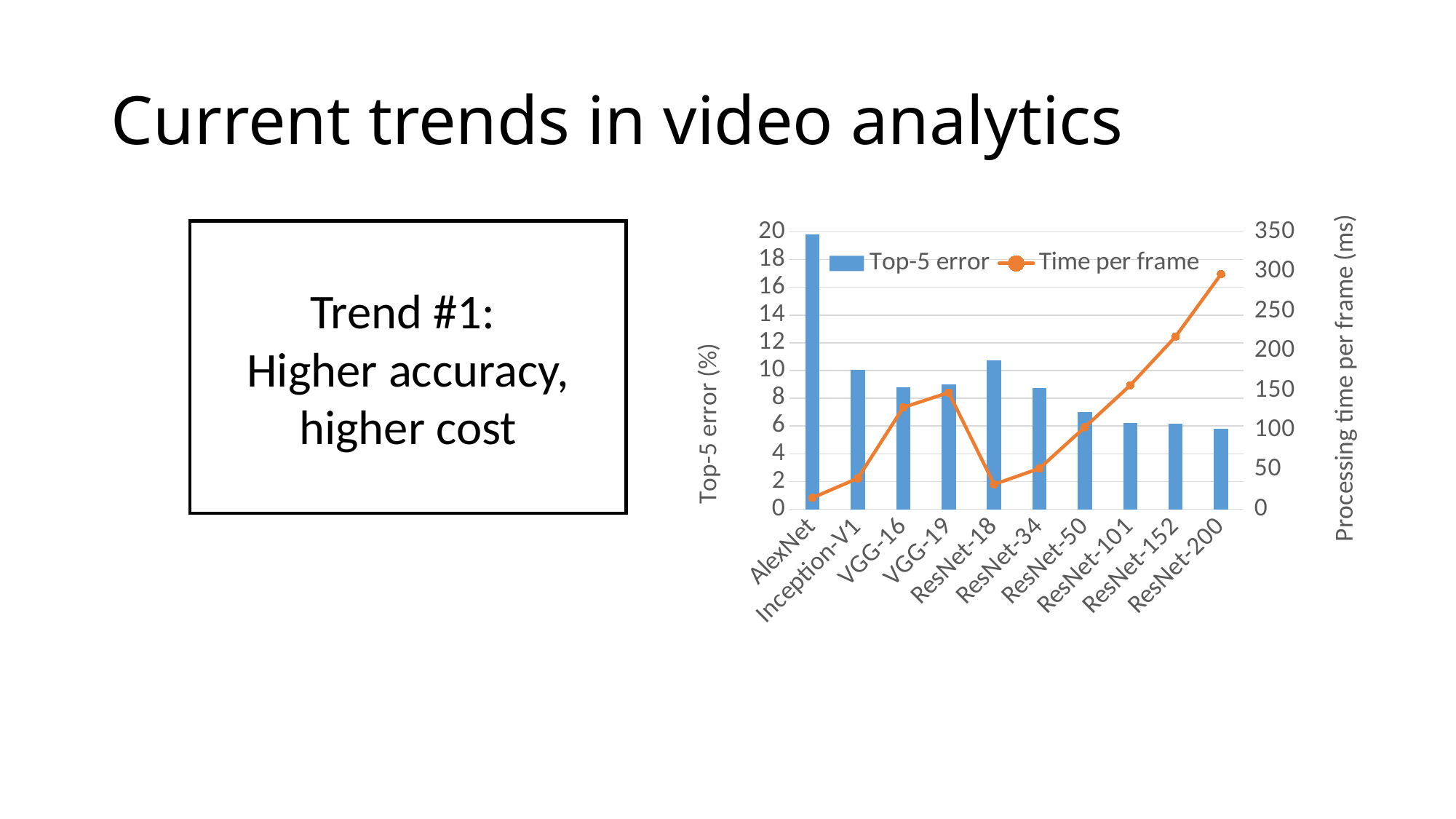
What kind of chart is shown on the slide? A combined bar and line chart Which has the larger time per frame, VGG-19 or ResNet-18? VGG-19 Is the time per frame for ResNet-18 greater or less than 50? less Which model has the lowest time per frame? AlexNet What is the label of the right-hand vertical axis? Processing time per frame (ms) Is the time per frame for ResNet-200 greater or less than 250? greater Is the Top-5 error for AlexNet greater or less than 18? greater Which model has the highest Top-5 error? AlexNet Does the time per frame rise or fall from ResNet-18 to ResNet-200? rise Which model has the highest time per frame? ResNet-200 How many models are shown on the x axis of the chart? 10 How many series does the chart's legend list? 2